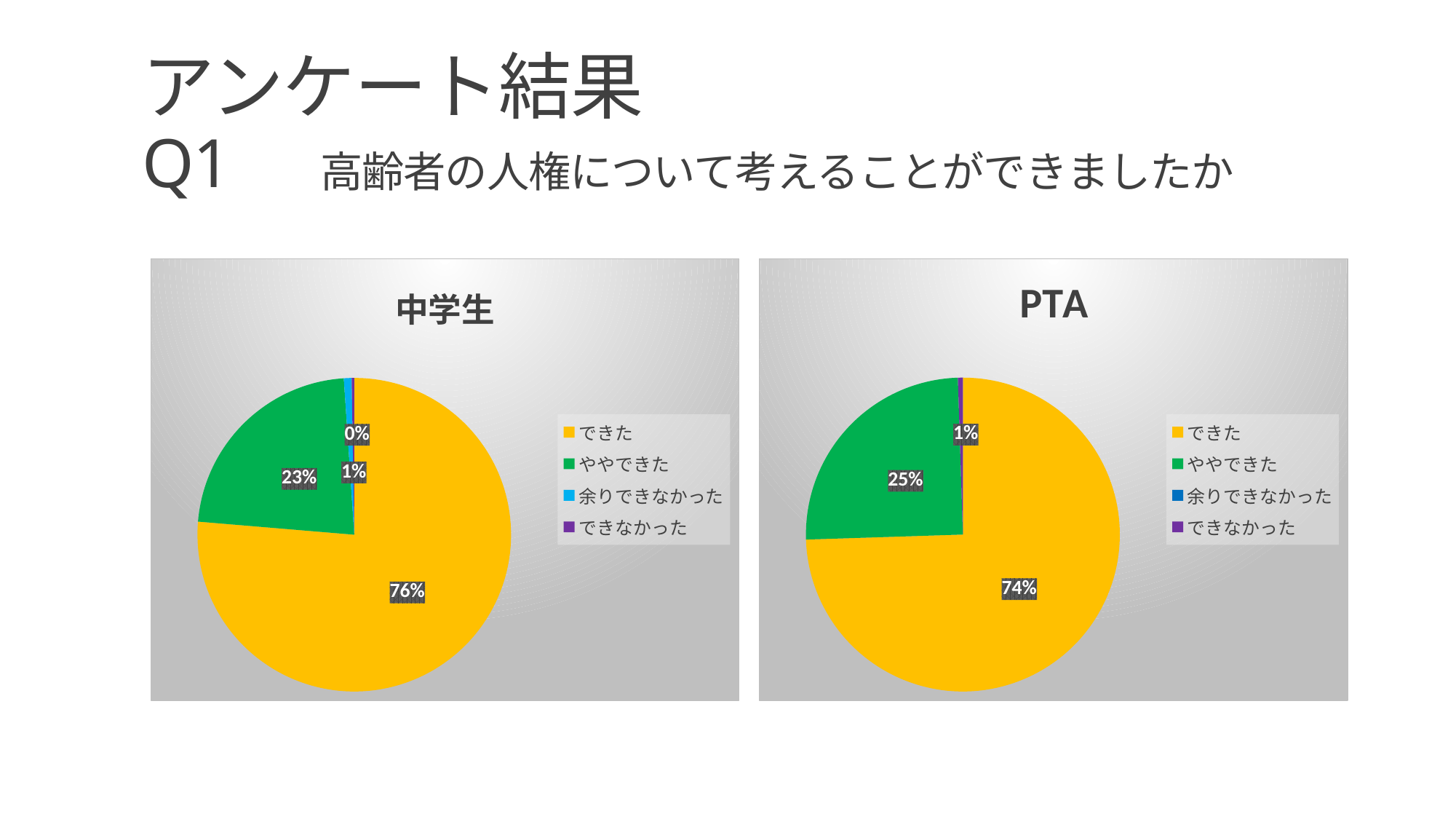
In the 中学生 chart, what percentage is shown for できた? 76% In the 中学生 chart, which category has the largest share? できた How many entries does the legend of the PTA chart list? 4 In the 中学生 chart, what percentage is shown for ややできた? 23% In the PTA chart, what percentage is shown for できた? 74% In the PTA chart, what is the difference between the できた and ややできた shares? 49% What type of chart is the 中学生 chart? Pie chart Which chart shows a larger share for ややできた, 中学生 or PTA? PTA In the 中学生 chart, what is the difference between the できた and ややできた shares? 53% Which chart shows a larger share for できた, 中学生 or PTA? 中学生 In the PTA chart, which category has the largest share? できた In the PTA chart, what percentage is shown for ややできた? 25%